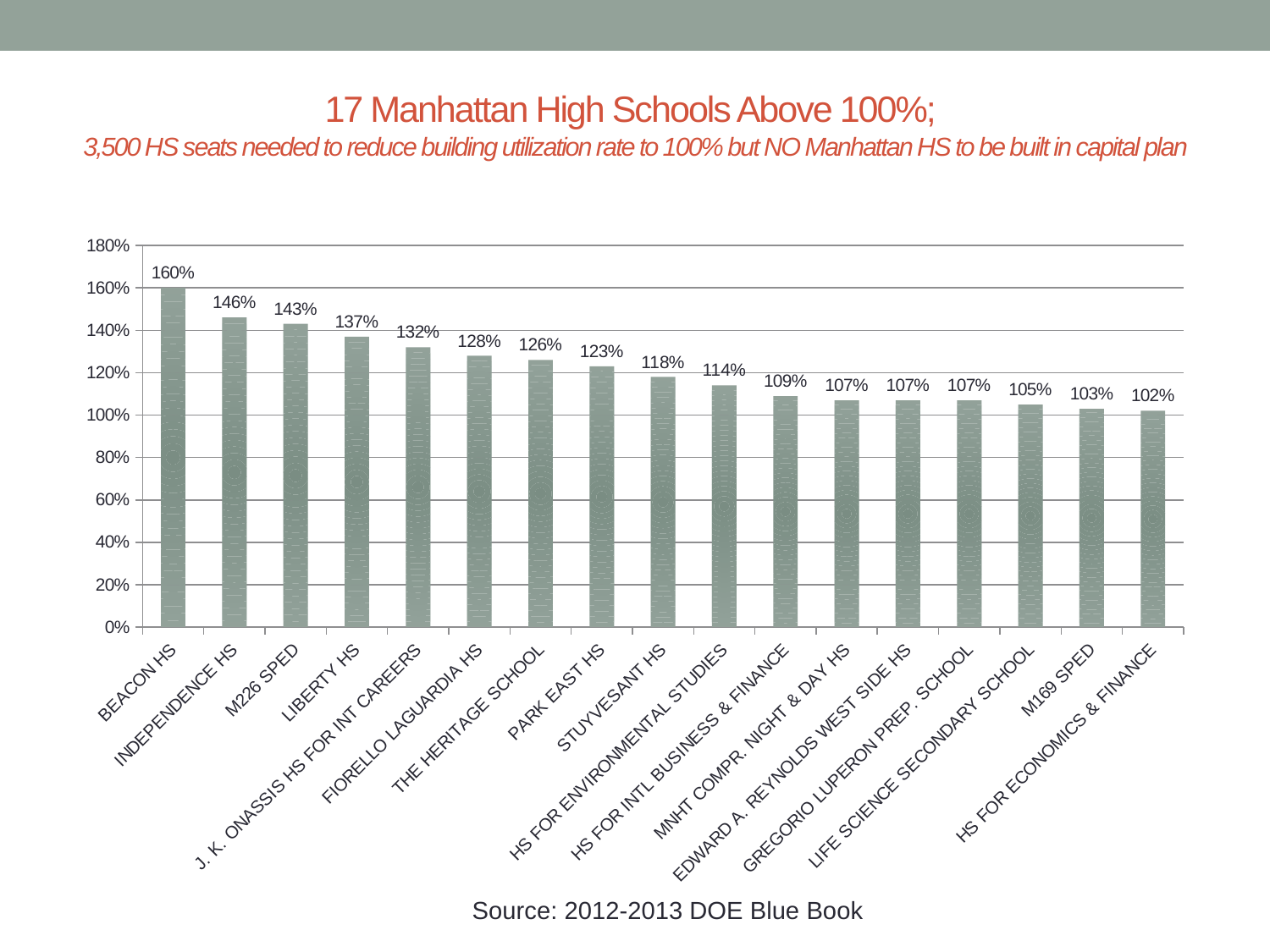
What is the difference between the values for BEACON HS and INDEPENDENCE HS? 14% Do the values rise or fall moving from left to right along the x axis? Fall Which school has the lowest utilization rate on the chart? HS FOR ECONOMICS & FINANCE Which school has the highest utilization rate on the chart? BEACON HS What kind of chart is shown on the slide? Bar chart Which has a higher value, M226 SPED or THE HERITAGE SCHOOL? M226 SPED What is the value shown for M169 SPED? 103% What is the value shown for STUYVESANT HS? 118% What is the difference between the values for LIBERTY HS and PARK EAST HS? 14% What is the value shown for FIORELLO LAGUARDIA HS? 128% How many schools are shown on the chart? 17 What is the utilization rate shown for BEACON HS? 160%